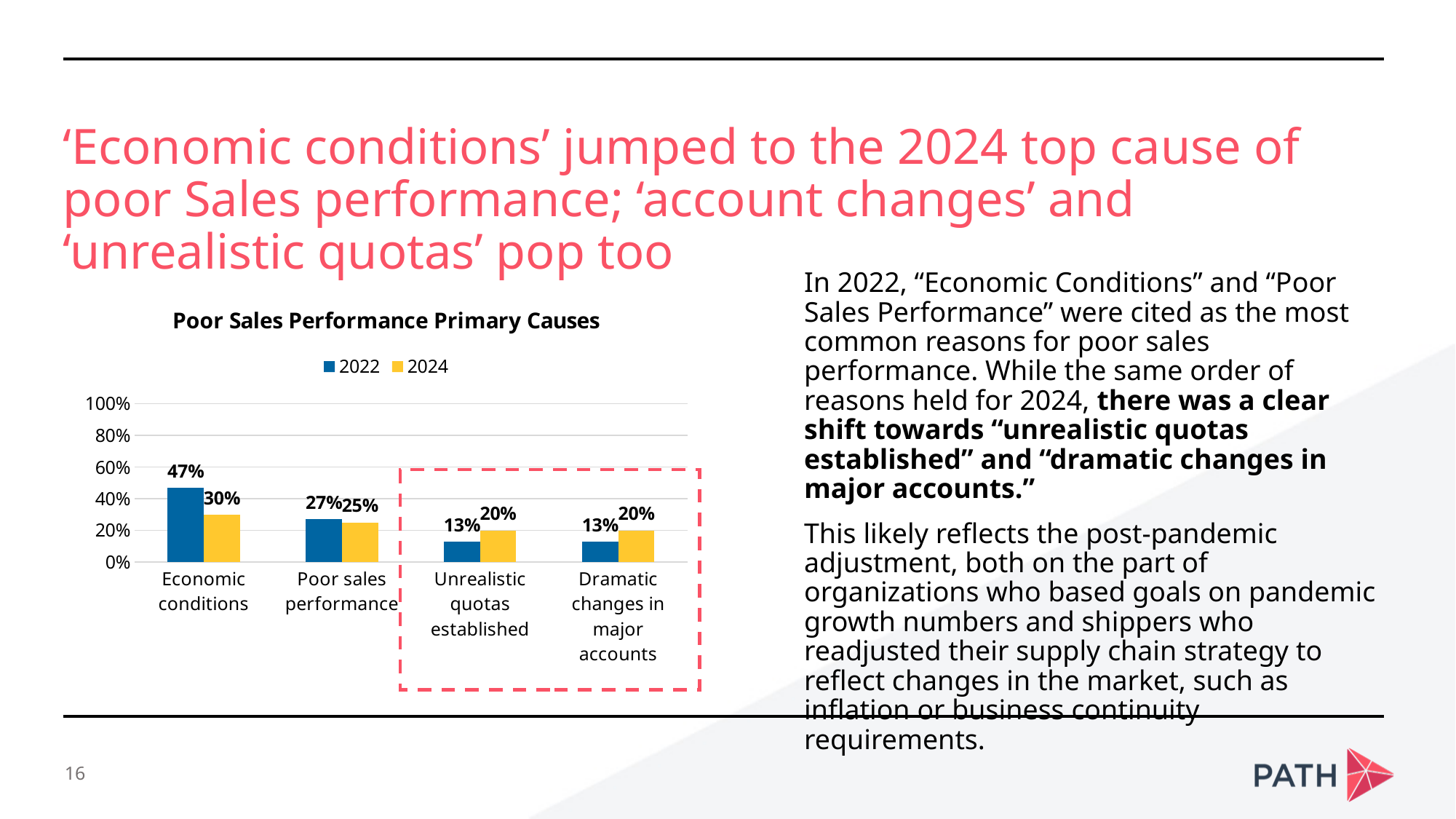
What is the 2024 value for Unrealistic quotas established? 20% What is the 2024 value for Poor sales performance? 25% What is the difference between the 2022 and 2024 values for Economic conditions? 17% What kind of chart is shown? Bar chart Which category has the lowest 2024 value? Unrealistic quotas established and Dramatic changes in major accounts (tied at 20%) How many categories are shown on the x axis? 4 Which is larger for Unrealistic quotas established: the 2022 value or the 2024 value? 2024 How many series does the legend list? 2 Which category has the highest 2022 value? Economic conditions What is the title of the chart? Poor Sales Performance Primary Causes What is the 2022 value for Economic conditions? 47% What is the 2022 value for Dramatic changes in major accounts? 13%